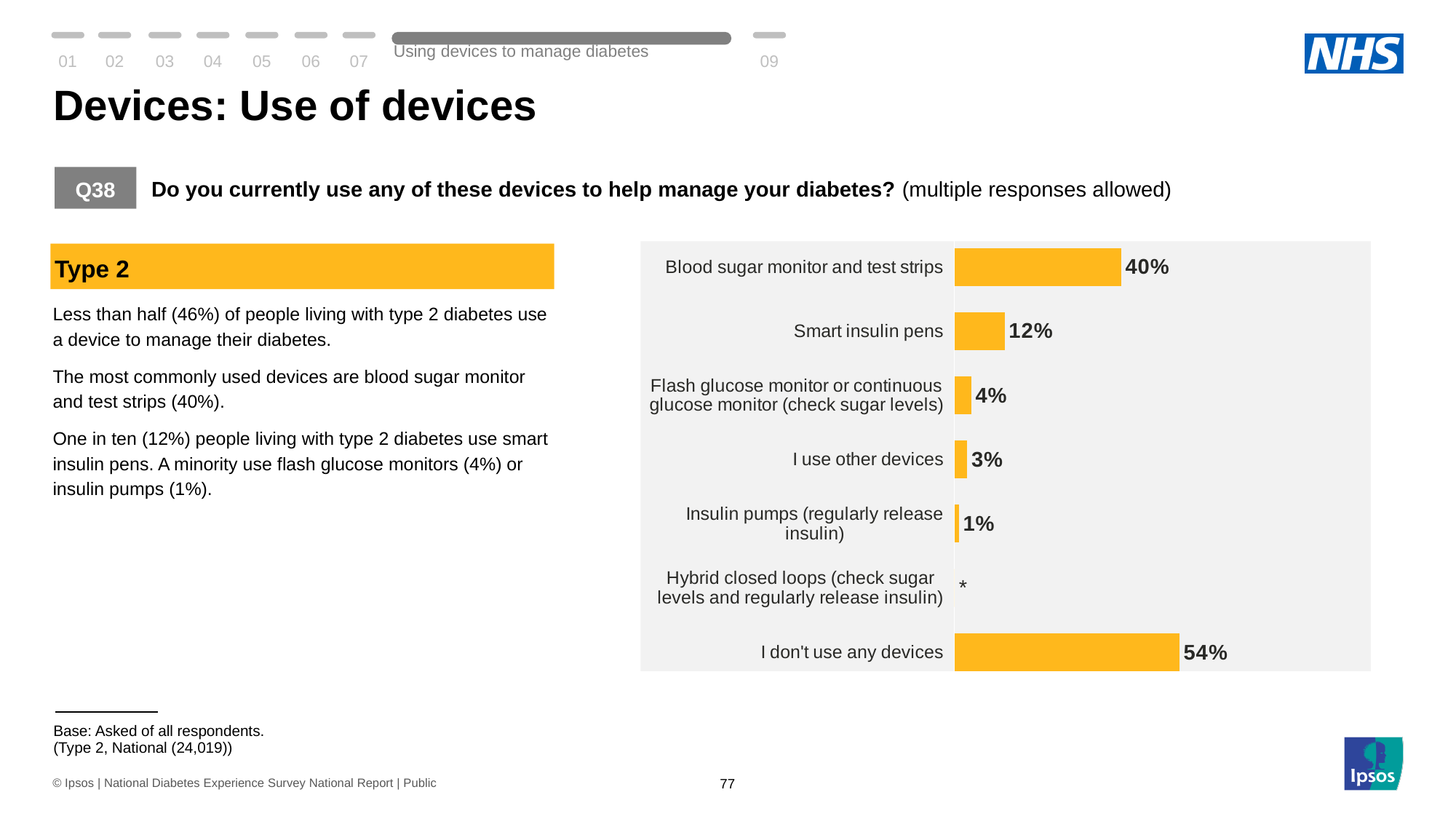
What percentage of respondents say they don't use any devices? 54% What kind of chart is shown on the slide? Bar chart What percentage of respondents use smart insulin pens? 12% How many categories are shown in the chart? 7 Which is larger: the value for 'I use other devices' or the value for 'Insulin pumps (regularly release insulin)'? I use other devices What percentage of respondents use a blood sugar monitor and test strips? 40% What percentage of respondents use a flash glucose monitor or continuous glucose monitor? 4% What is the difference between the percentage who don't use any devices and the percentage who use a blood sugar monitor and test strips? 14% Which category has the highest value in the chart? I don't use any devices What percentage of respondents use insulin pumps? 1% What is the difference between the percentage using smart insulin pens and the percentage using a flash glucose monitor or continuous glucose monitor? 8% Which device is the most commonly used according to the chart? Blood sugar monitor and test strips